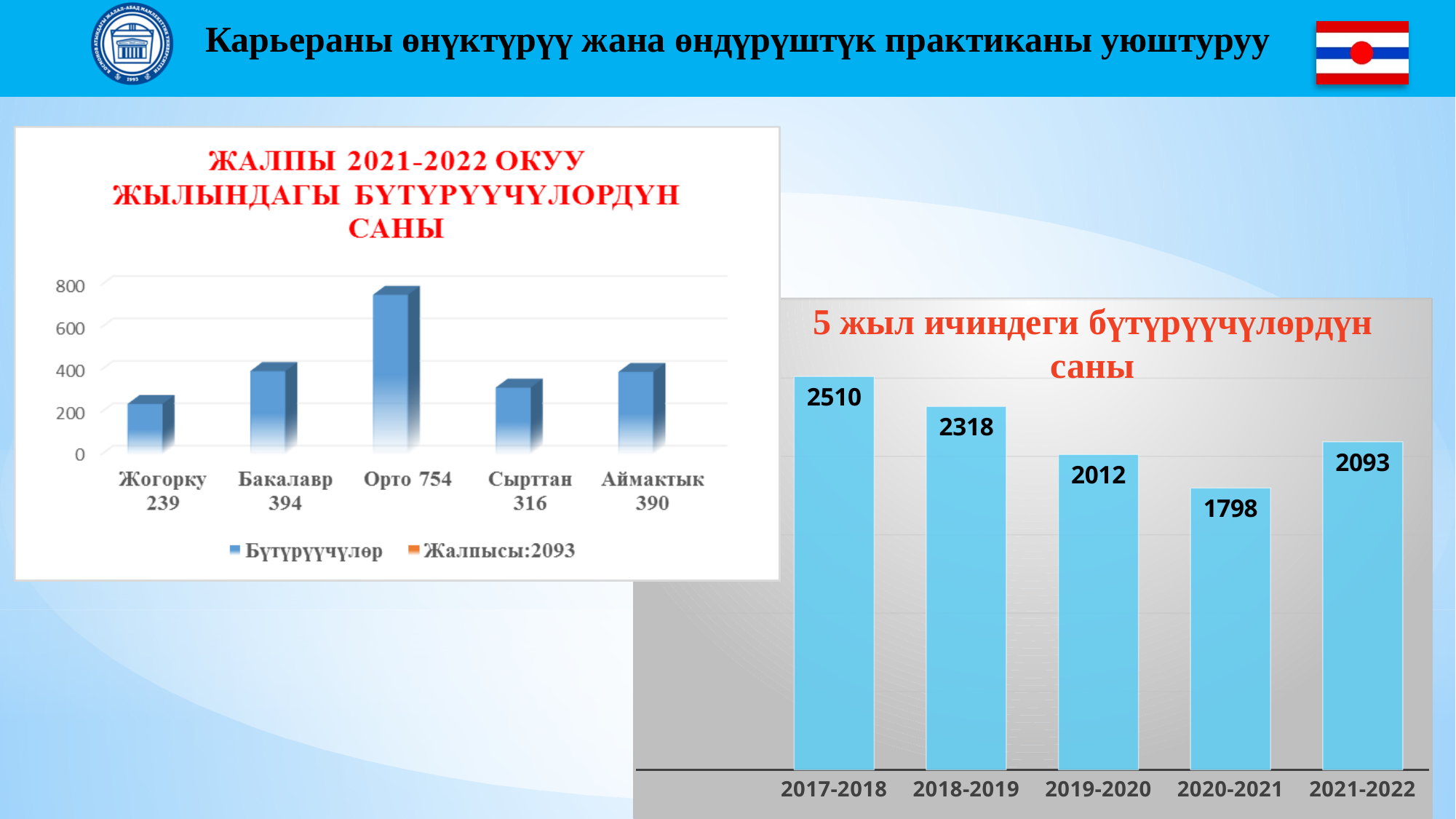
In the right chart (5 жыл ичиндеги бүтүрүүчүлөрдүн саны), what is the value for 2020-2021? 1798 In the left chart (ЖАЛПЫ 2021-2022 ОКУУ ЖЫЛЫНДАГЫ БҮТҮРҮҮЧҮЛӨРДҮН САНЫ), how many entries does the legend list? 2 What kind of chart is the right chart (5 жыл ичиндеги бүтүрүүчүлөрдүн саны)? Bar chart In the left chart (ЖАЛПЫ 2021-2022 ОКУУ ЖЫЛЫНДАГЫ БҮТҮРҮҮЧҮЛӨРДҮН САНЫ), what is the value for Жогорку? 239 In the right chart (5 жыл ичиндеги бүтүрүүчүлөрдүн саны), which is larger: 2019-2020 or 2021-2022? 2021-2022 In the left chart (ЖАЛПЫ 2021-2022 ОКУУ ЖЫЛЫНДАГЫ БҮТҮРҮҮЧҮЛӨРДҮН САНЫ), how many categories are shown? 5 In the right chart (5 жыл ичиндеги бүтүрүүчүлөрдүн саны), what is the difference between 2017-2018 and 2018-2019? 192 In the left chart (ЖАЛПЫ 2021-2022 ОКУУ ЖЫЛЫНДАГЫ БҮТҮРҮҮЧҮЛӨРДҮН САНЫ), what is the difference between Бакалавр and Сырттан? 78 In the left chart (ЖАЛПЫ 2021-2022 ОКУУ ЖЫЛЫНДАГЫ БҮТҮРҮҮЧҮЛӨРДҮН САНЫ), which category has the lowest value? Жогорку In the left chart (ЖАЛПЫ 2021-2022 ОКУУ ЖЫЛЫНДАГЫ БҮТҮРҮҮЧҮЛӨРДҮН САНЫ), which category has the highest value? Орто In the right chart (5 жыл ичиндеги бүтүрүүчүлөрдүн саны), which year has the highest value? 2017-2018 In the left chart (ЖАЛПЫ 2021-2022 ОКУУ ЖЫЛЫНДАГЫ БҮТҮРҮҮЧҮЛӨРДҮН САНЫ), what is the value for Орто? 754